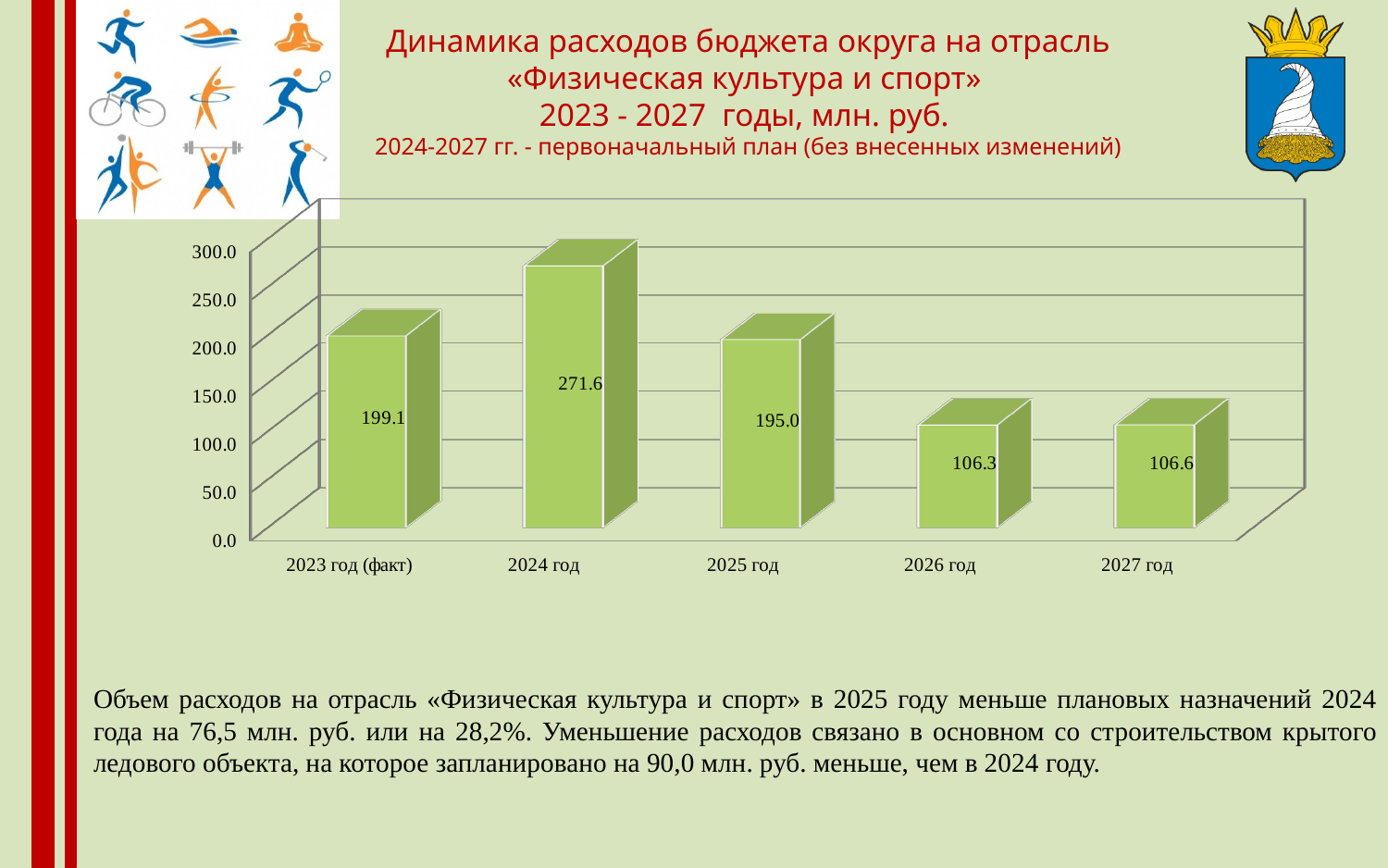
How many years are shown on the x axis? 5 What is the value for 2024 год? 271.6 What is the value for 2026 год? 106.3 What is the difference between the values for 2027 год and 2026 год? 0.3 Is the value for 2025 год greater or less than 150.0? greater What is the difference between the values for 2024 год and 2025 год? 76.6 Which year has the highest value? 2024 год Which is larger, the value for 2023 год (факт) or the value for 2025 год? 2023 год (факт) What is the value for 2027 год? 106.6 What kind of chart is shown on the slide? bar chart What is the value for 2023 год (факт)? 199.1 Which year has the lowest value? 2026 год